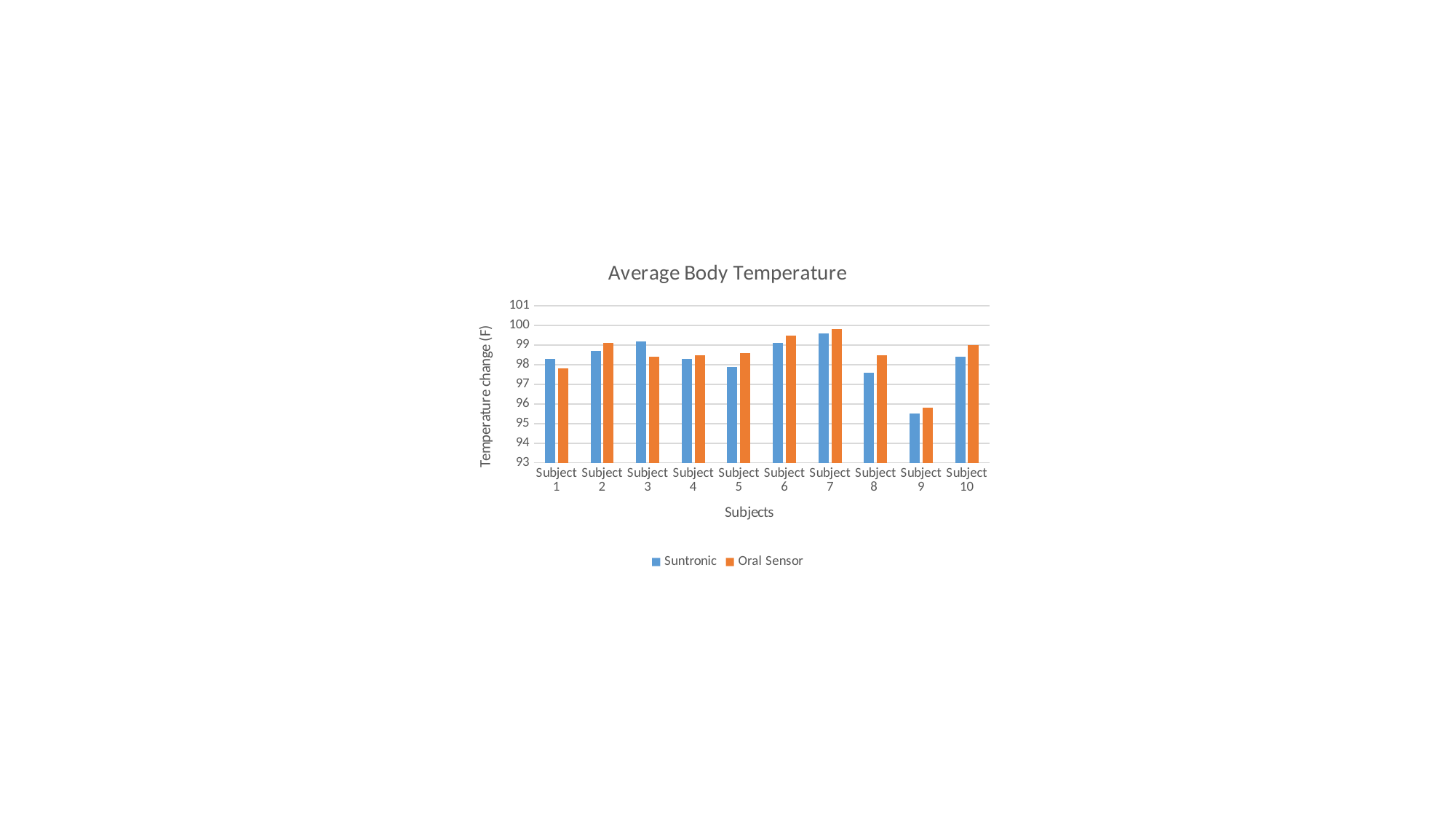
Is the Suntronic value for Subject 8 greater or less than 98? less For Subject 8, which is larger, the Suntronic value or the Oral Sensor value? Oral Sensor Is the Suntronic value for Subject 9 greater or less than 96? less Which subject has the lowest Suntronic value? Subject 9 Which subject has the highest Oral Sensor value? Subject 7 What is the label on the vertical axis? Temperature change (F) What is the title of the chart? Average Body Temperature Is the Oral Sensor value for Subject 7 greater or less than 99? greater How many series does the legend list? 2 What kind of chart is shown on the slide? Bar chart How many subjects are shown on the x axis of the chart? 10 Which subject has the lowest Oral Sensor value? Subject 9